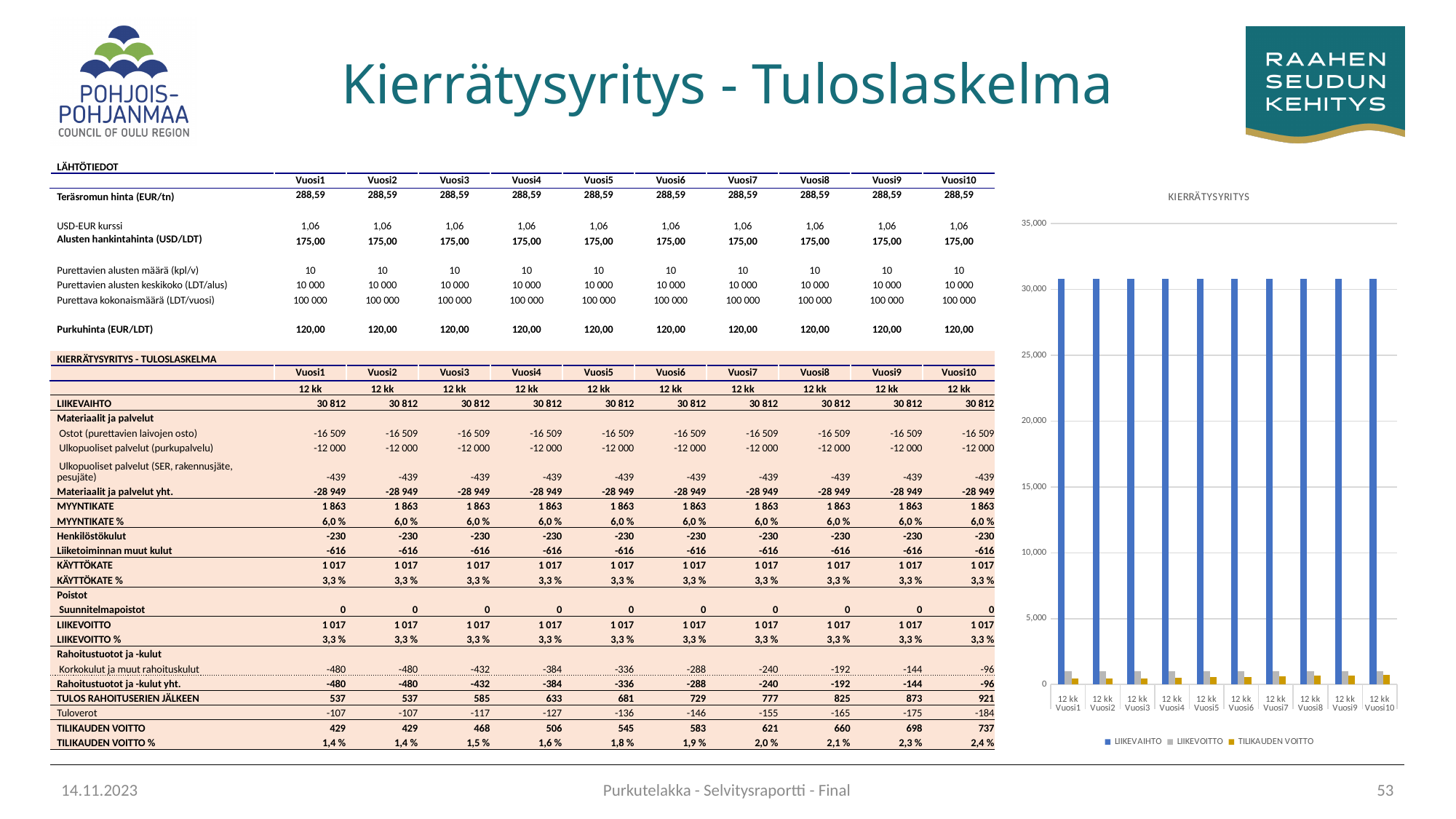
Is the TILIKAUDEN VOITTO value for 12 kk Vuosi10 greater or less than 5,000? less Which series in the chart is drawn in blue? LIIKEVAIHTO What is the title of the chart? KIERRÄTYSYRITYS Is the LIIKEVOITTO value for 12 kk Vuosi5 greater or less than 5,000? less Is the LIIKEVAIHTO value for 12 kk Vuosi1 greater or less than 30,000? greater Which series has the tallest bars in the chart? LIIKEVAIHTO Do the LIIKEVAIHTO bars rise, fall, or stay the same from Vuosi1 to Vuosi10? stay the same How many categories (years) are plotted along the x axis of the chart? 10 For 12 kk Vuosi3, which is larger: LIIKEVAIHTO or LIIKEVOITTO? LIIKEVAIHTO What kind of chart is shown on the slide? bar chart How many series does the chart legend list? 3